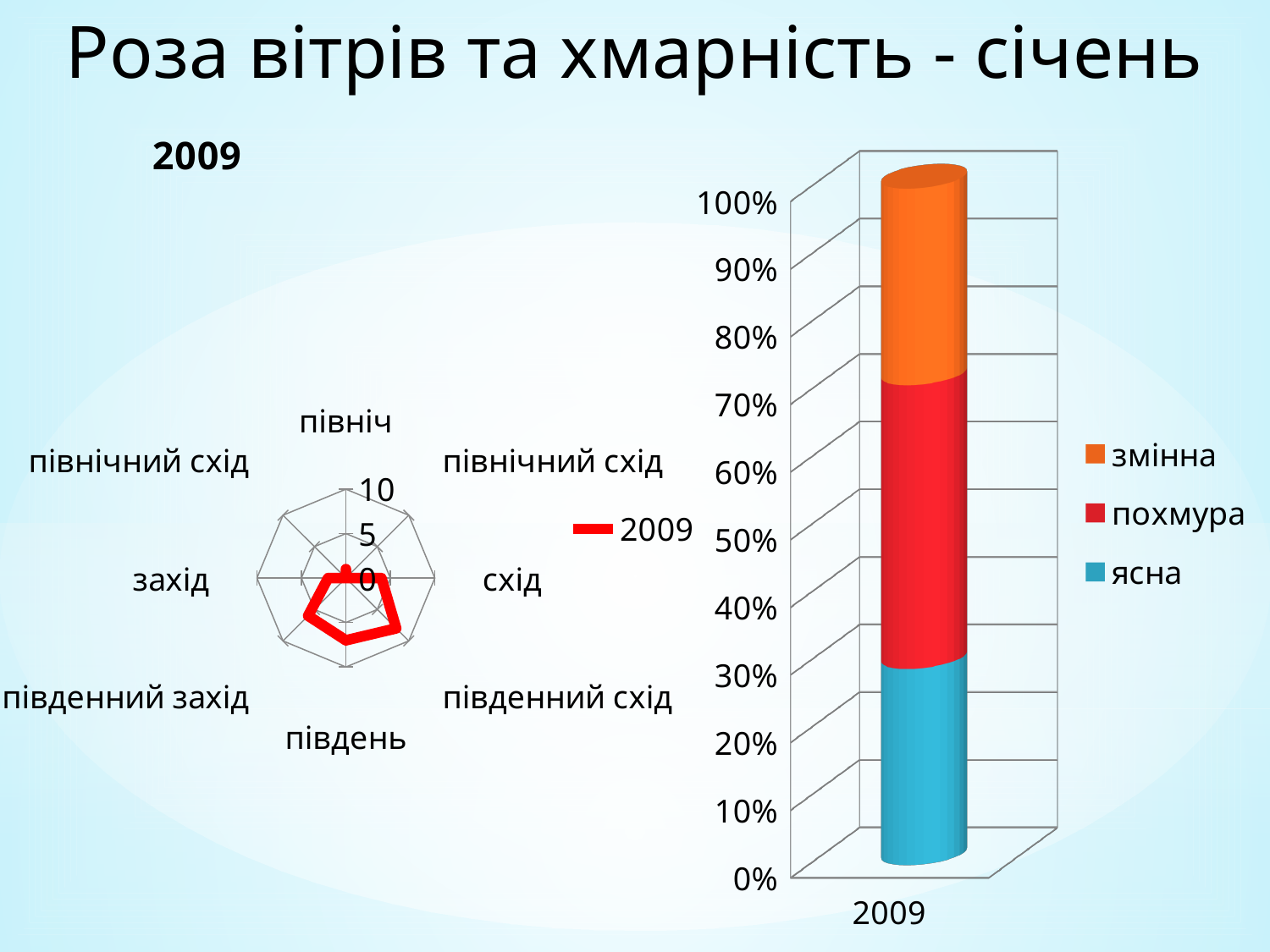
In the bar chart on the right, how many categories are shown on the x axis? 1 In the bar chart on the right, what are the series names listed in the legend? змінна, похмура, ясна In the bar chart on the right, how many series does the legend list? 3 In the radar chart on the left, is the value for північ greater or less than 5? less In the bar chart on the right, is the value for ясна greater or less than 50%? less What kind of chart is the chart on the right side of the slide? bar chart In the radar chart on the left, which is larger, the value for південь or the value for північ? південь In the bar chart on the right, which series is shown in orange? змінна What kind of chart is the chart on the left side of the slide, titled 2009? radar chart In the radar chart on the left, which direction has the highest value? південний схід In the radar chart on the left, is the value for південний схід greater or less than 5? greater In the radar chart on the left, how many direction categories are plotted? 8